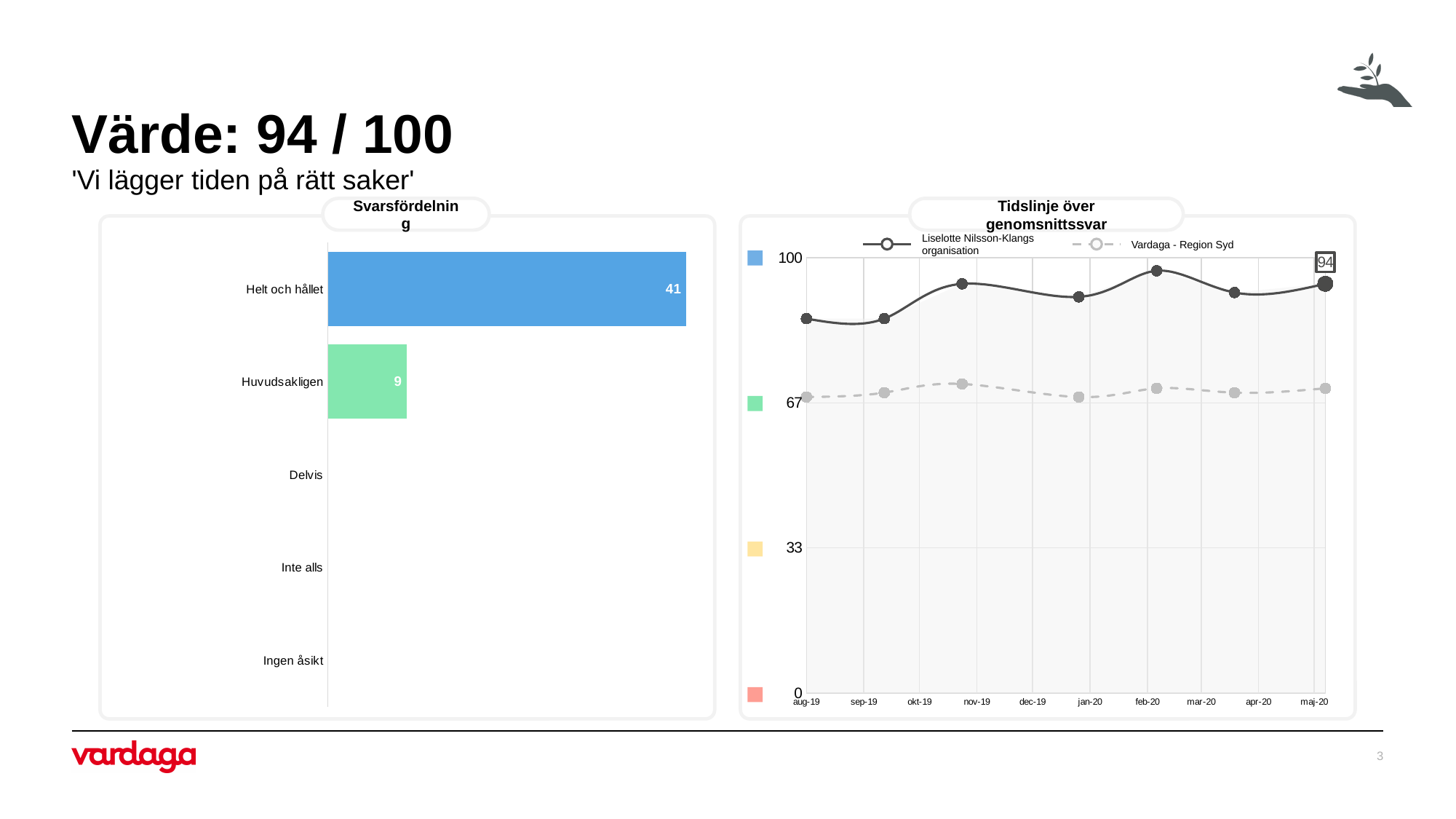
How many series does the legend of the Tidslinje över genomsnittssvar chart list? 2 In the Svarsfördelning chart, which category has the highest value? Helt och hållet What kind of chart is the Svarsfördelning chart? Bar chart In the Svarsfördelning chart, what is the value for Huvudsakligen? 9 How many categories are shown on the y axis of the Svarsfördelning chart? 5 In the Tidslinje över genomsnittssvar chart, what is the value for Liselotte Nilsson-Klangs organisation at maj-20? 94 In the Tidslinje över genomsnittssvar chart, is the value for Liselotte Nilsson-Klangs organisation at aug-19 greater or less than 67? greater What kind of chart is the Tidslinje över genomsnittssvar chart? Line chart In the Tidslinje över genomsnittssvar chart, which series has the higher value at maj-20? Liselotte Nilsson-Klangs organisation In the Svarsfördelning chart, what is the value for Helt och hållet? 41 In the Svarsfördelning chart, what is the difference between the values for Helt och hållet and Huvudsakligen? 32 How many time points are shown on the x axis of the Tidslinje över genomsnittssvar chart? 10